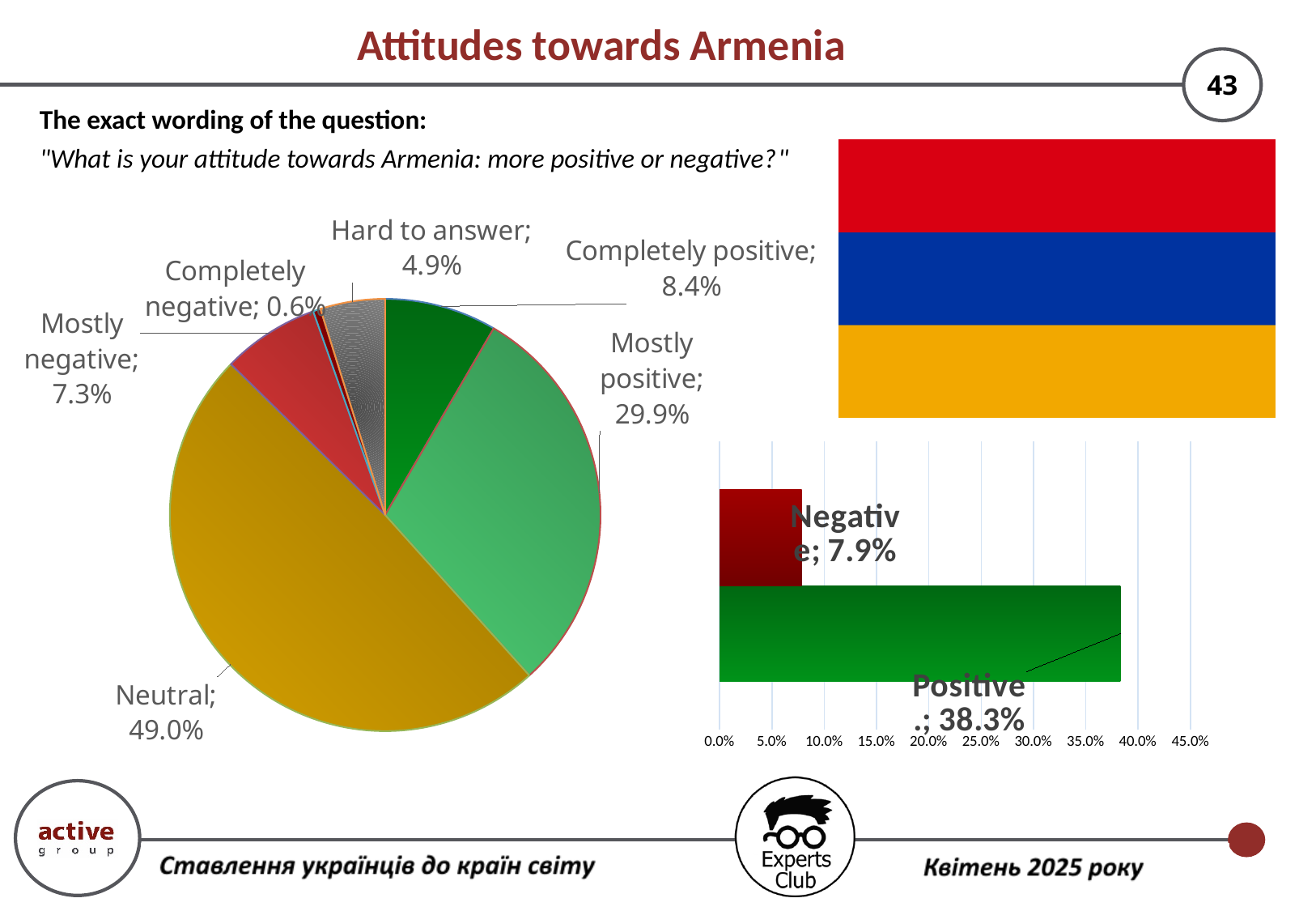
In the pie chart, what share of respondents answered "Neutral"? 49.0% In the bar chart on the right, what is the value for "Positive"? 38.3% In the pie chart, what is the difference between "Mostly positive" and "Completely positive"? 21.5% In the pie chart, which is larger: "Mostly negative" or "Hard to answer"? Mostly negative In the pie chart, what is the value for "Mostly positive"? 29.9% What type of chart is shown on the right side of the slide? Bar chart In the bar chart on the right, what is the value for "Negative"? 7.9% In the pie chart, which category has the smallest slice? Completely negative In the pie chart, how many slices are there? 6 In the pie chart, what is the value for "Completely negative"? 0.6% In the bar chart on the right, what is the difference between "Positive" and "Negative"? 30.4% In the pie chart, which category has the largest slice? Neutral